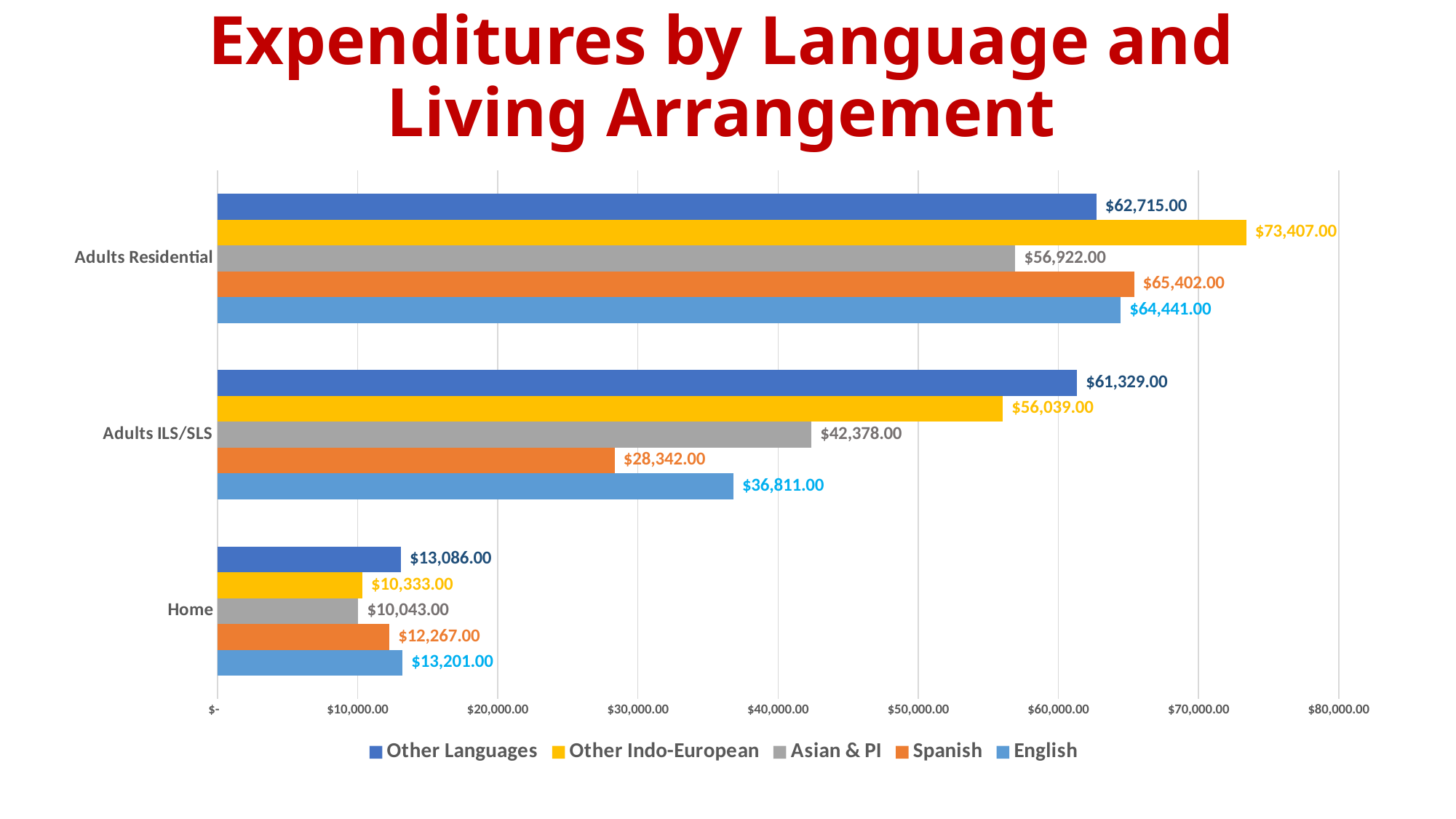
What is the expenditure for Asian & PI in the Home category? $10,043.00 Which language group has the highest expenditure in the Adults Residential category? Other Indo-European What is the expenditure for Spanish in the Adults ILS/SLS category? $28,342.00 How many living arrangement categories are shown on the chart? 3 Which language group has the lowest expenditure in the Adults ILS/SLS category? Spanish What is the difference between the Other Indo-European and Asian & PI expenditures in the Adults Residential category? $16,485.00 In the Home category, which is larger: the expenditure for Other Languages or for Spanish? Other Languages What is the difference between the Other Languages and Spanish expenditures in the Adults ILS/SLS category? $32,987.00 What kind of chart is shown on the slide? Bar chart What is the expenditure for English in the Adults Residential category? $64,441.00 How many series does the legend list? 5 Is the expenditure for Asian & PI in the Adults ILS/SLS category greater or less than $40,000.00? greater